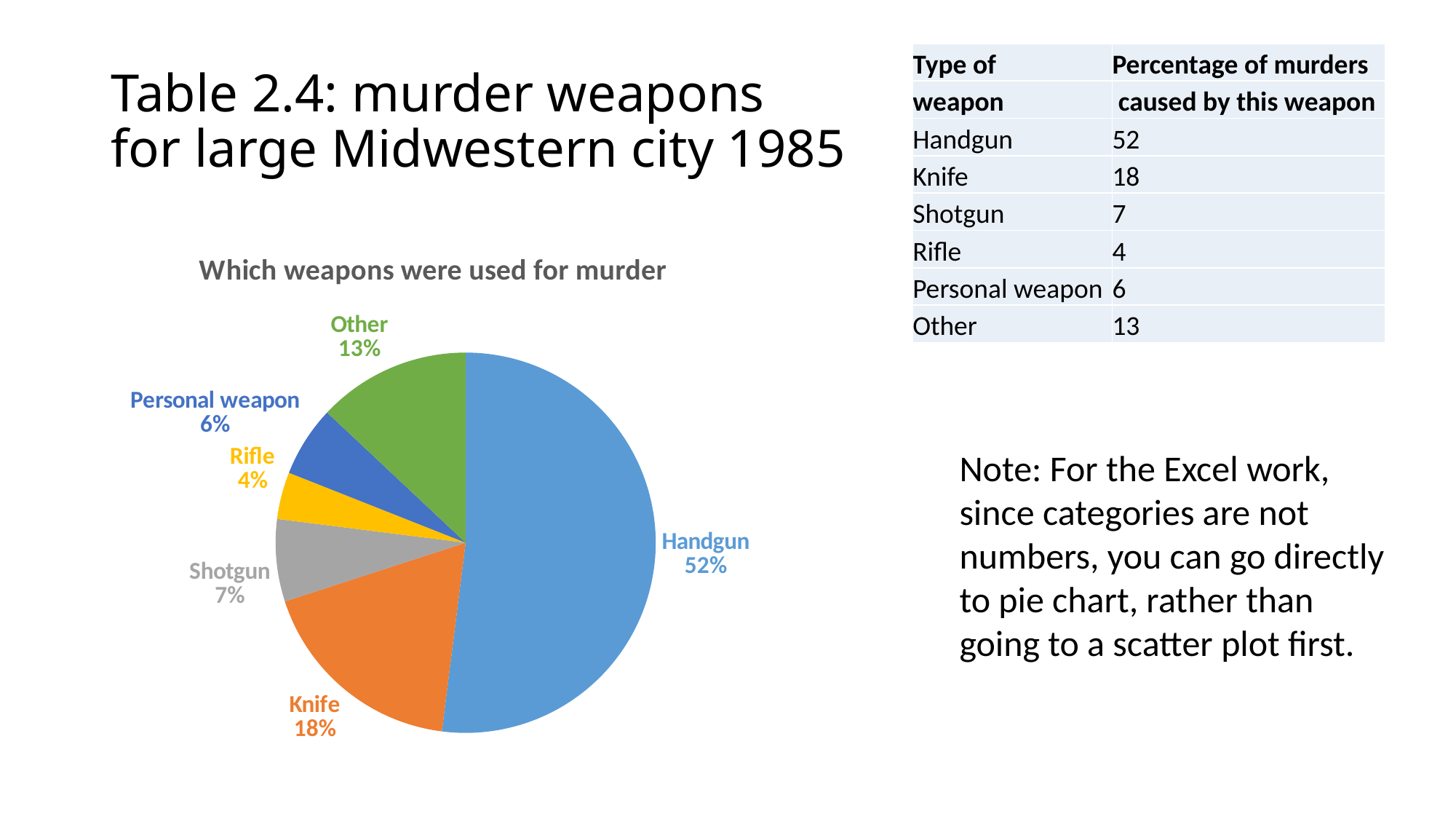
How many categories are shown in the pie chart? 6 Which weapon category has the smallest slice? Rifle Which is larger, the Other slice or the Shotgun slice? Other What is the value shown for Shotgun? 7% What is the value shown for Personal weapon? 6% What colour is the Rifle slice? yellow What kind of chart is shown on the slide? pie chart What is the difference between the Handgun and Knife percentages? 34% What is the value shown for Knife? 18% Which weapon category has the largest slice? Handgun What is the title of the chart? Which weapons were used for murder What share of the pie does Handgun represent? 52%